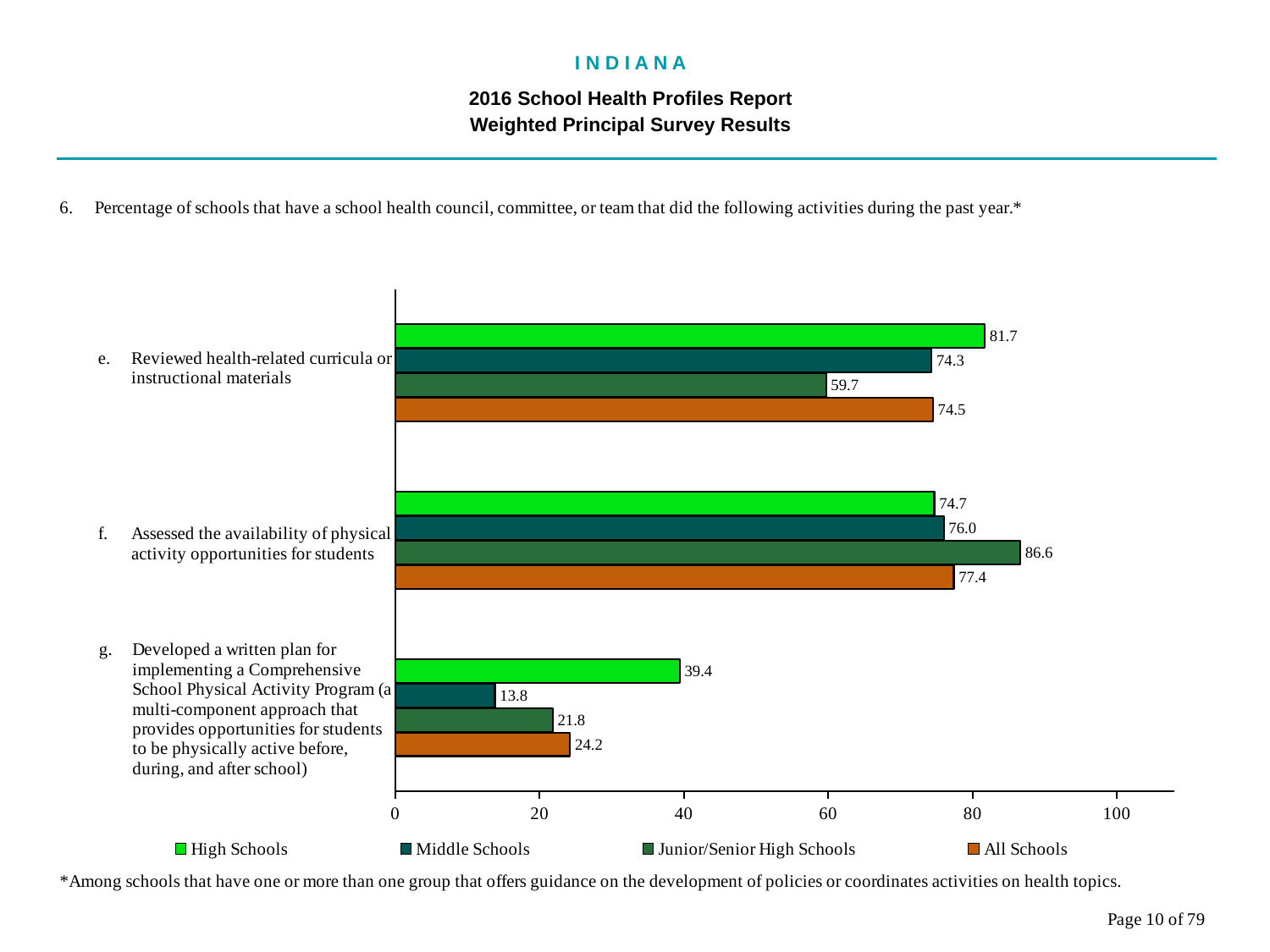
Which series has the highest value for 'Assessed the availability of physical activity opportunities for students'? Junior/Senior High Schools What is the value for High Schools for 'Reviewed health-related curricula or instructional materials'? 81.7 What is the value for Middle Schools for 'Developed a written plan for implementing a Comprehensive School Physical Activity Program'? 13.8 How many activity categories are shown on the chart? 3 What is the difference between the High Schools and Junior/Senior High Schools values for 'Reviewed health-related curricula or instructional materials'? 22.0 What is the value for All Schools for 'Assessed the availability of physical activity opportunities for students'? 77.4 Which is larger for 'Developed a written plan for implementing a Comprehensive School Physical Activity Program': High Schools or All Schools? High Schools How many series does the legend list? 4 What kind of chart is shown on the slide? Bar chart What is the value for Junior/Senior High Schools for 'Assessed the availability of physical activity opportunities for students'? 86.6 Which series has the lowest value for 'Developed a written plan for implementing a Comprehensive School Physical Activity Program'? Middle Schools Is the Junior/Senior High Schools value for 'Reviewed health-related curricula or instructional materials' greater or less than 60? less